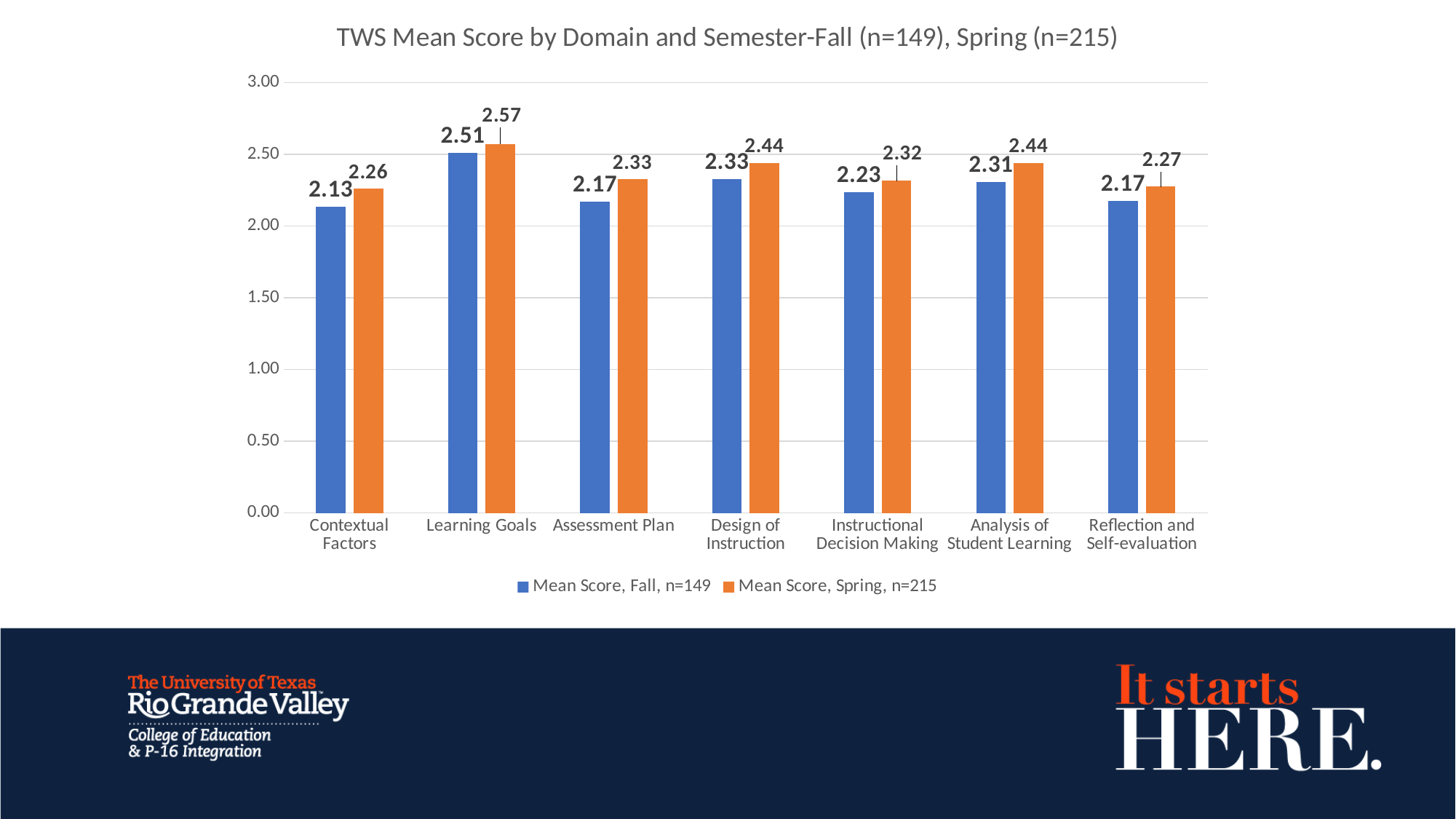
What is the difference between the Fall mean scores for Learning Goals and Contextual Factors? 0.38 How many series does the legend list? 2 What kind of chart is shown on the slide? Bar chart What is the Fall mean score for Learning Goals? 2.51 What is the difference between the Spring and Fall mean scores for Analysis of Student Learning? 0.13 What is the Spring mean score for Instructional Decision Making? 2.32 What is the Fall mean score for Reflection and Self-evaluation? 2.17 Which domain has the highest Spring mean score? Learning Goals What is the title of the chart? TWS Mean Score by Domain and Semester-Fall (n=149), Spring (n=215) Which is larger: the Fall mean score for Design of Instruction or the Fall mean score for Instructional Decision Making? Design of Instruction How many domains are shown on the x axis? 7 Which domain has the lowest Fall mean score? Contextual Factors